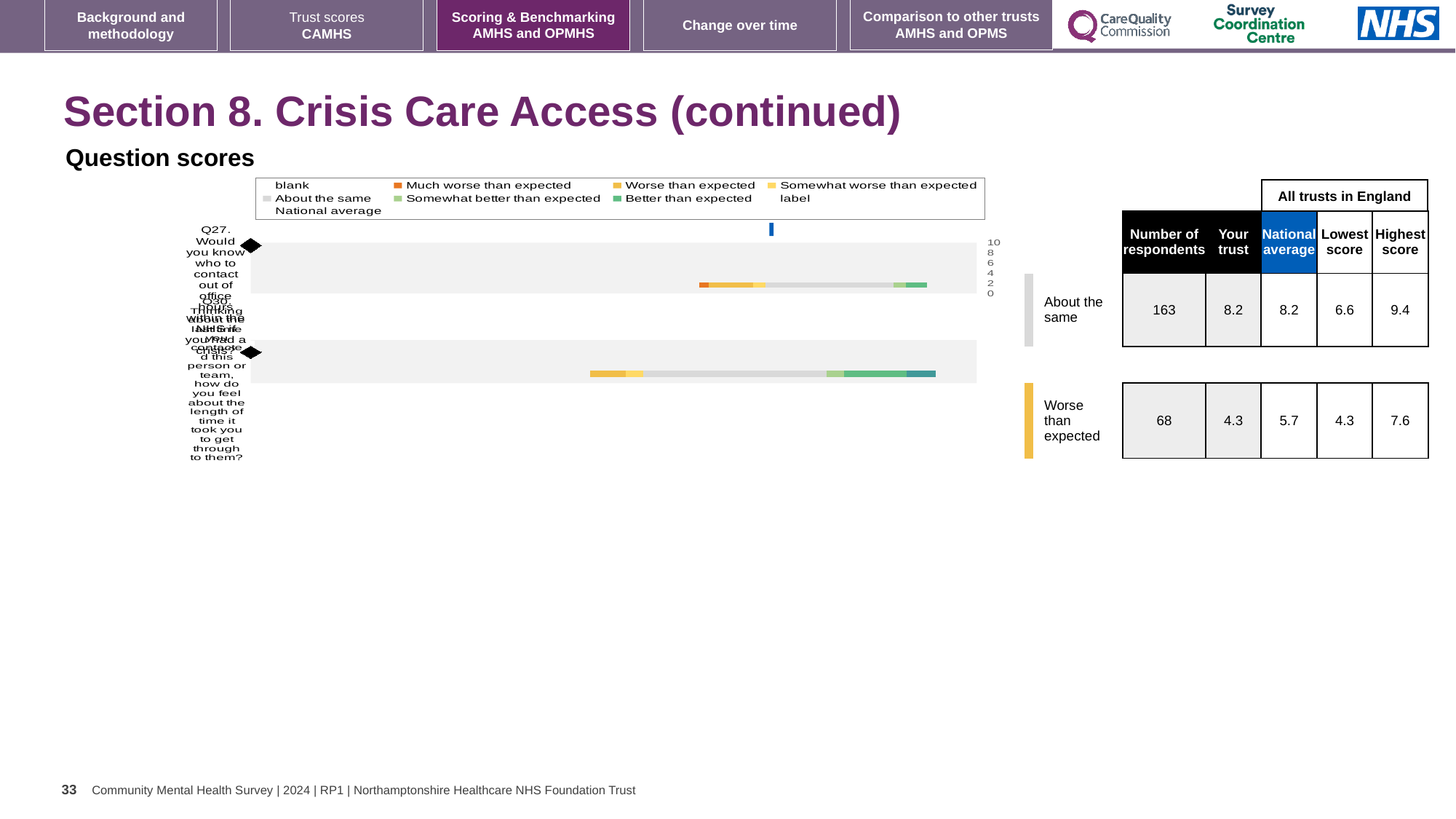
How many questions (categories) are plotted in the bar chart? 2 How many entries does the chart legend list? 9 In the table beside the chart, what is the number of respondents for the 'About the same' row? 163 In the table beside the chart, what is the highest score for the 'About the same' row? 9.4 In the table beside the chart, what is the difference between the highest and lowest scores for the 'About the same' row? 2.8 What is the highest value shown on the chart's numeric axis? 10 In the table beside the chart, what is the difference between the national average and the 'Your trust' score for the 'Worse than expected' row? 1.4 In the table beside the chart, what is the 'Your trust' score for the 'Worse than expected' row? 4.3 In the table beside the chart, for the 'Worse than expected' row, which is larger: the 'Your trust' score or the national average? National average Which legend entry is shown in orange-red? Much worse than expected In the table beside the chart, what is the national average for the 'Worse than expected' row? 5.7 What kind of chart is shown under 'Question scores'? bar chart